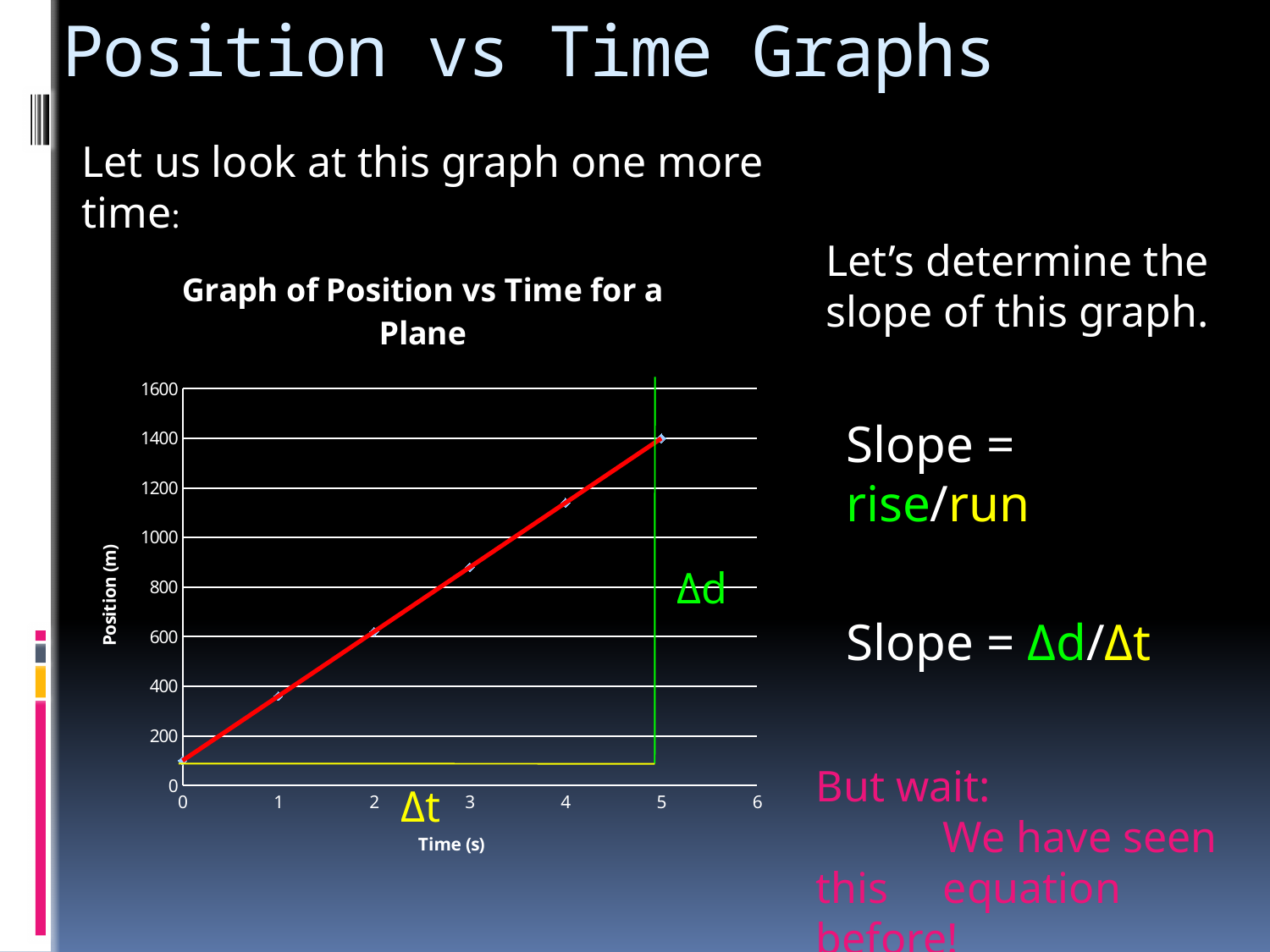
Do the plotted position values rise or fall as time increases along the x axis? rise What kind of chart is shown on the slide? line chart Is the position value at time 3 s greater or less than 800? greater What is the label of the vertical axis of the chart? Position (m) Is the position value at time 0 s greater or less than 200? less Is the position value at time 1 s greater or less than 400? less Which has the larger position value: time 4 s or time 2 s? time 4 s At which time value is the plotted position highest? 5 How many data points are plotted on the chart? 6 At which time value is the plotted position lowest? 0 What is the title of the chart? Graph of Position vs Time for a Plane